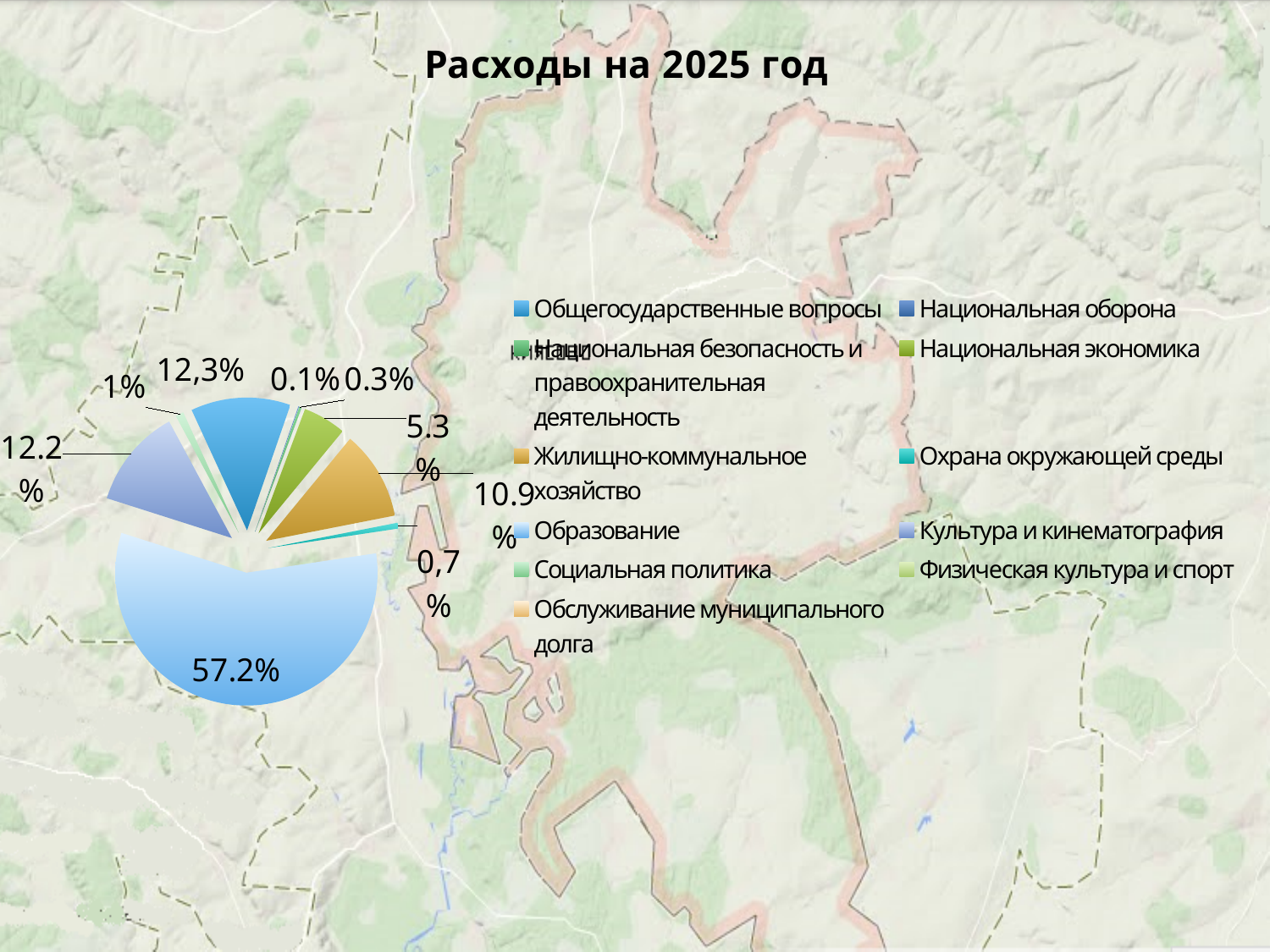
How many categories does the legend list? 11 What is the value shown for Общегосударственные вопросы? 12,3% Which is larger, the share for Образование or the share for Жилищно-коммунальное хозяйство? Образование What is the title of the chart? Расходы на 2025 год What kind of chart is shown on the slide? pie chart What is the value shown for Культура и кинематография? 12.2% What share of the pie does Образование have? 57.2% What is the value shown for Национальная экономика? 5.3% Which category has the largest share of the pie? Образование What is the value shown for Жилищно-коммунальное хозяйство? 10.9% What is the smallest value printed on the chart? 0.1% What is the difference between the share for Образование (57.2%) and the share for Общегосударственные вопросы (12,3%)? 44.9%